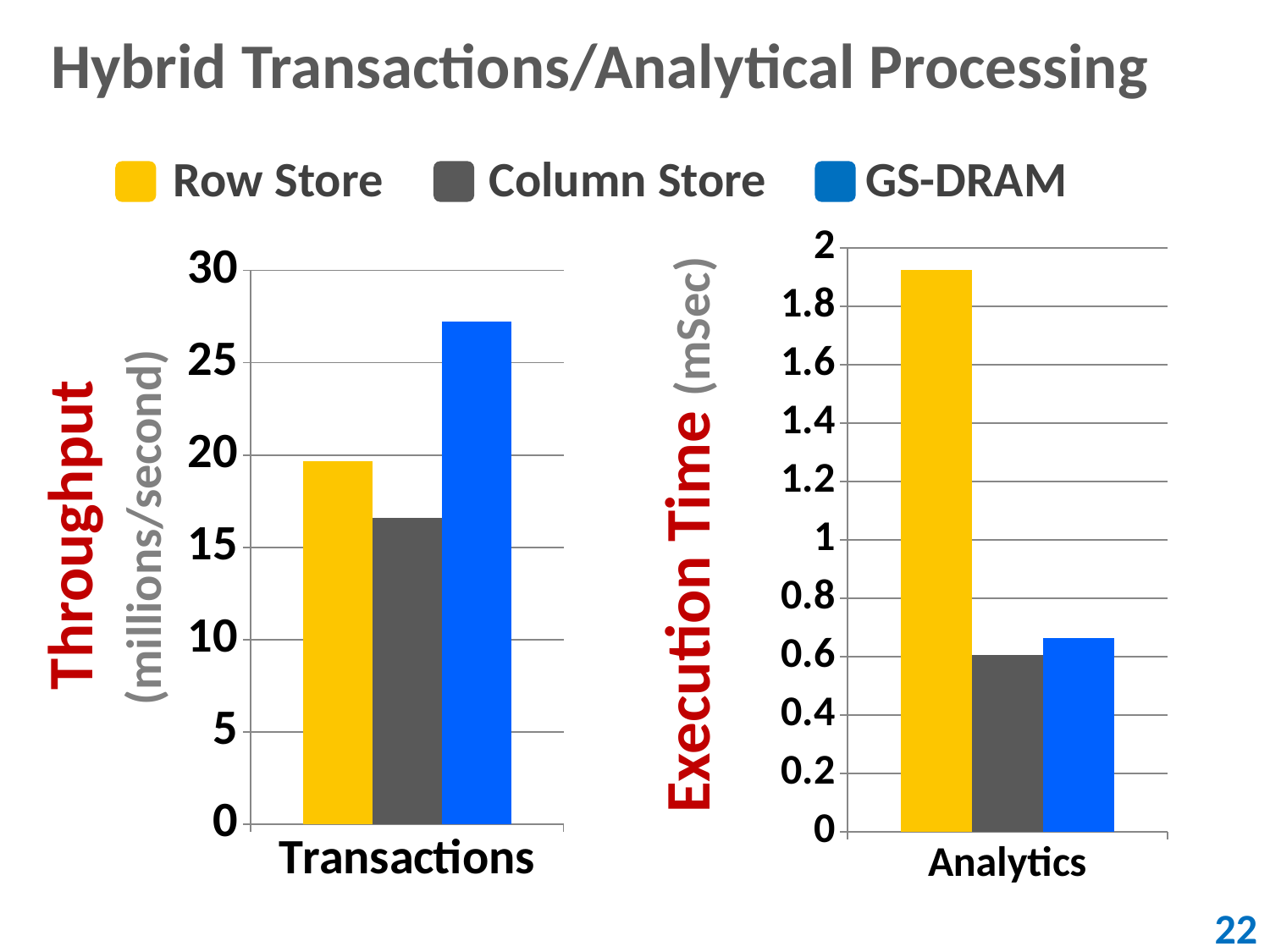
How many series does the legend list? 3 In the Execution Time chart, is the GS-DRAM value for Analytics greater or less than 1? less In the Throughput chart, which series has the lowest value for Transactions? Column Store In the Throughput chart, is the Column Store value for Transactions greater or less than 20? less What unit is shown on the y-axis of the Execution Time chart? mSec In the Execution Time chart, which is larger for Analytics: Row Store or Column Store? Row Store In the Throughput chart, which series has the highest value for Transactions? GS-DRAM In the Throughput chart, is the GS-DRAM value for Transactions greater or less than 25? greater In the Throughput chart, which is larger for Transactions: Row Store or Column Store? Row Store What kind of chart is the Throughput chart? Bar chart In the Execution Time chart, which series has the highest value for Analytics? Row Store